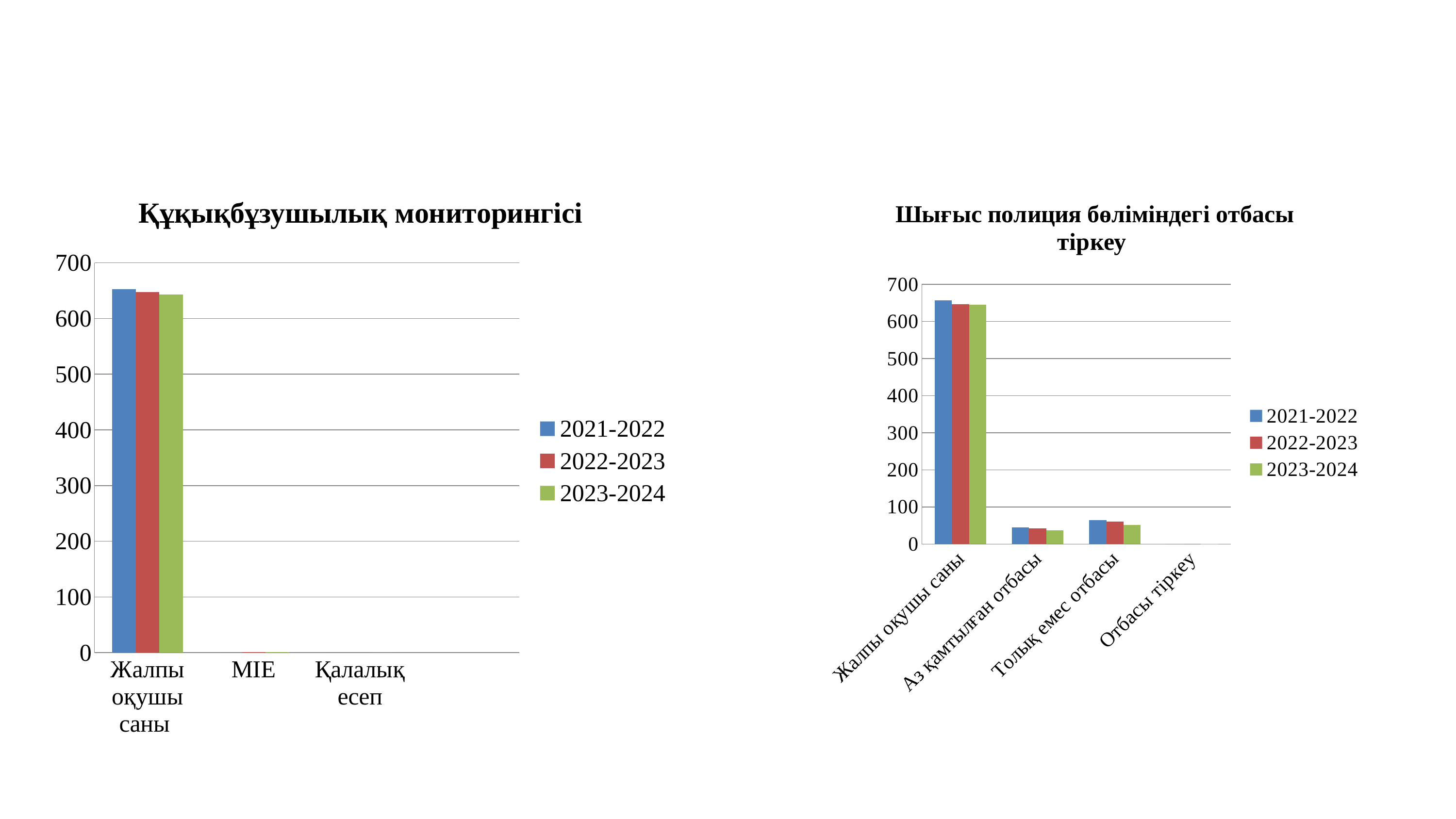
In the 'Құқықбұзушылық мониторингісі' chart, is the 2021-2022 value for 'Жалпы оқушы саны' greater or less than 600? greater In the 'Шығыс полиция бөліміндегі отбасы тіркеу' chart, which is larger for 2021-2022: 'Аз қамтылған отбасы' or 'Толық емес отбасы'? Толық емес отбасы How many series does the legend of the 'Құқықбұзушылық мониторингісі' chart list? 3 What kind of chart is the 'Шығыс полиция бөліміндегі отбасы тіркеу' chart? bar chart In the 'Құқықбұзушылық мониторингісі' chart, which category has the highest values? Жалпы оқушы саны How many categories are shown on the x axis of the 'Шығыс полиция бөліміндегі отбасы тіркеу' chart? 4 In the 'Шығыс полиция бөліміндегі отбасы тіркеу' chart, is the 2021-2022 value for 'Толық емес отбасы' greater or less than 100? less How many series does the legend of the 'Шығыс полиция бөліміндегі отбасы тіркеу' chart list? 3 In the 'Құқықбұзушылық мониторингісі' chart, is the 2023-2024 value for 'МІЕ' greater or less than 100? less What kind of chart is the 'Құқықбұзушылық мониторингісі' chart? bar chart Which series is shown in green in the legend of the 'Шығыс полиция бөліміндегі отбасы тіркеу' chart? 2023-2024 How many categories are shown on the x axis of the 'Құқықбұзушылық мониторингісі' chart? 3